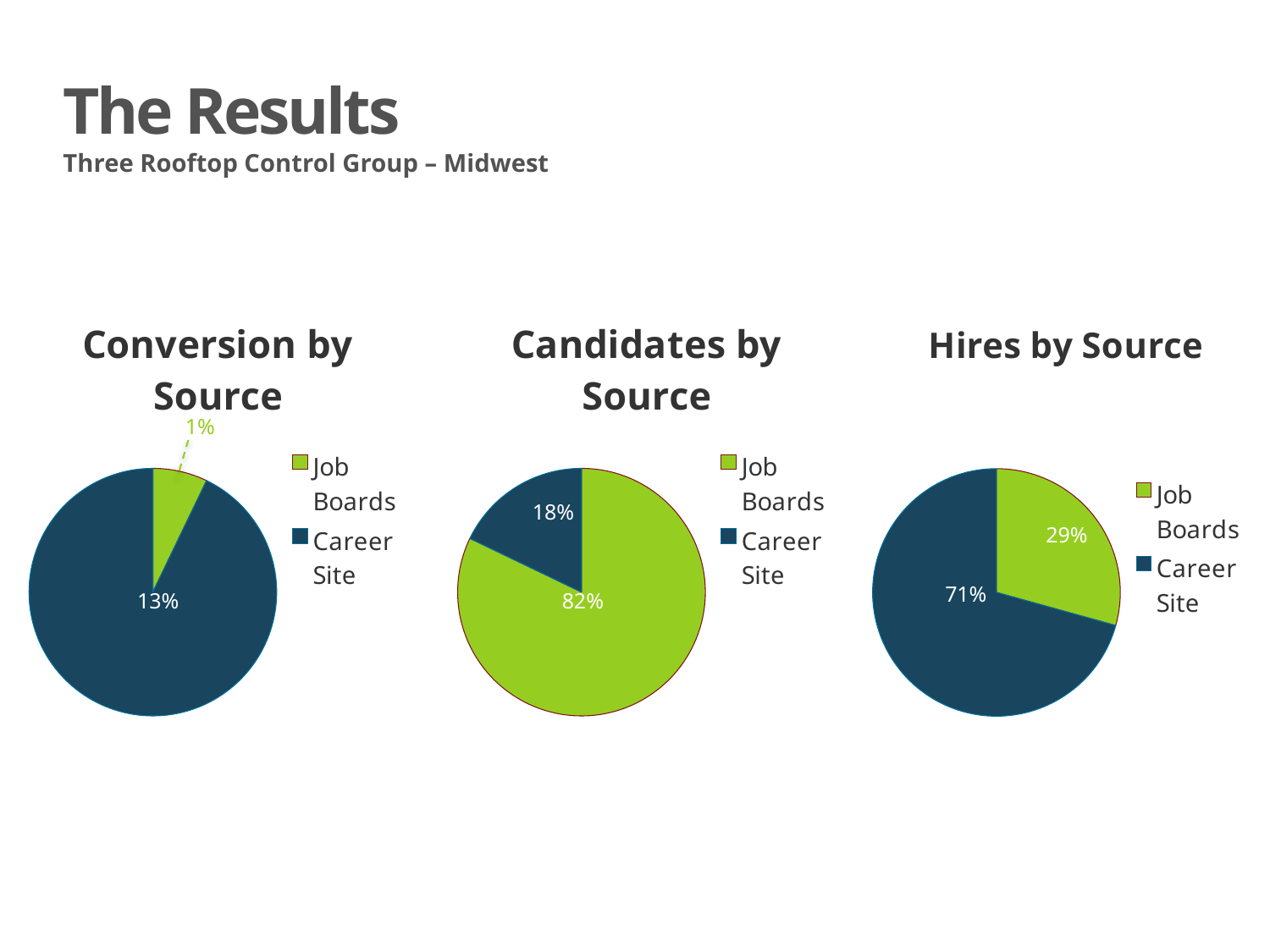
In the 'Candidates by Source' chart, what is the value for Career Site? 18% In the 'Candidates by Source' chart, what is the value for Job Boards? 82% In the 'Hires by Source' chart, what is the difference between the Career Site and Job Boards values? 42% What kind of chart is 'Hires by Source'? Pie chart In the 'Hires by Source' chart, what is the value for Career Site? 71% In the 'Conversion by Source' chart, what is the value for Job Boards? 1% In the 'Conversion by Source' chart, what is the value for Career Site? 13% In the 'Candidates by Source' chart, which is larger, Job Boards or Career Site? Job Boards In the 'Hires by Source' chart, which source has the largest slice? Career Site In the 'Hires by Source' chart, what is the value for Job Boards? 29% In the 'Candidates by Source' chart, which source has the smallest slice? Career Site How many series does the legend of the 'Conversion by Source' chart list? 2